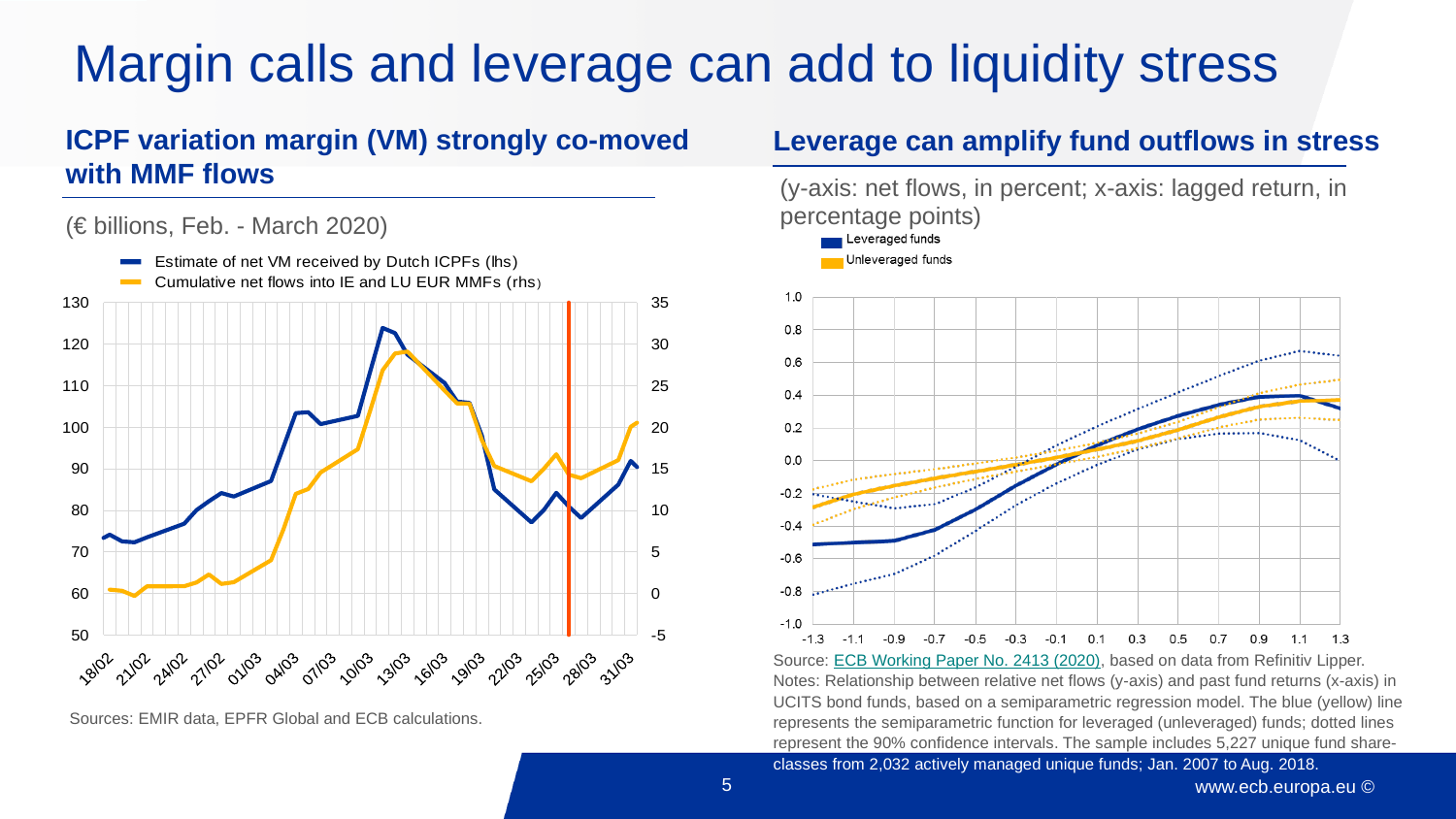
In the left chart, does the 'Cumulative net flows into IE and LU EUR MMFs' series rise or fall between 13/03 and 19/03? fall What kind of chart is the left chart, 'ICPF variation margin (VM) strongly co-moved with MMF flows'? Line chart In the left chart, does the 'Estimate of net VM received by Dutch ICPFs' series rise or fall overall between 18/02 and 13/03? rise In the left chart, is the value of the 'Estimate of net VM received by Dutch ICPFs' series at 18/02 greater or less than 80? less In the right chart, at a lagged return of -1.3, which series has the lower net flow, leveraged funds or unleveraged funds? Leveraged funds In the right chart, at a lagged return of -1.3, is the net flow for leveraged funds greater or less than -0.4? less How many series does the legend of the left chart list? 2 In the right chart, which colour represents leveraged funds? Blue In the left chart, is the peak value of the 'Estimate of net VM received by Dutch ICPFs' series greater or less than 120? greater What kind of chart is the right chart, 'Leverage can amplify fund outflows in stress'? Line chart In the left chart, which axis does the series 'Cumulative net flows into IE and LU EUR MMFs' use? Right-hand side (rhs) How many series does the legend of the right chart list? 2